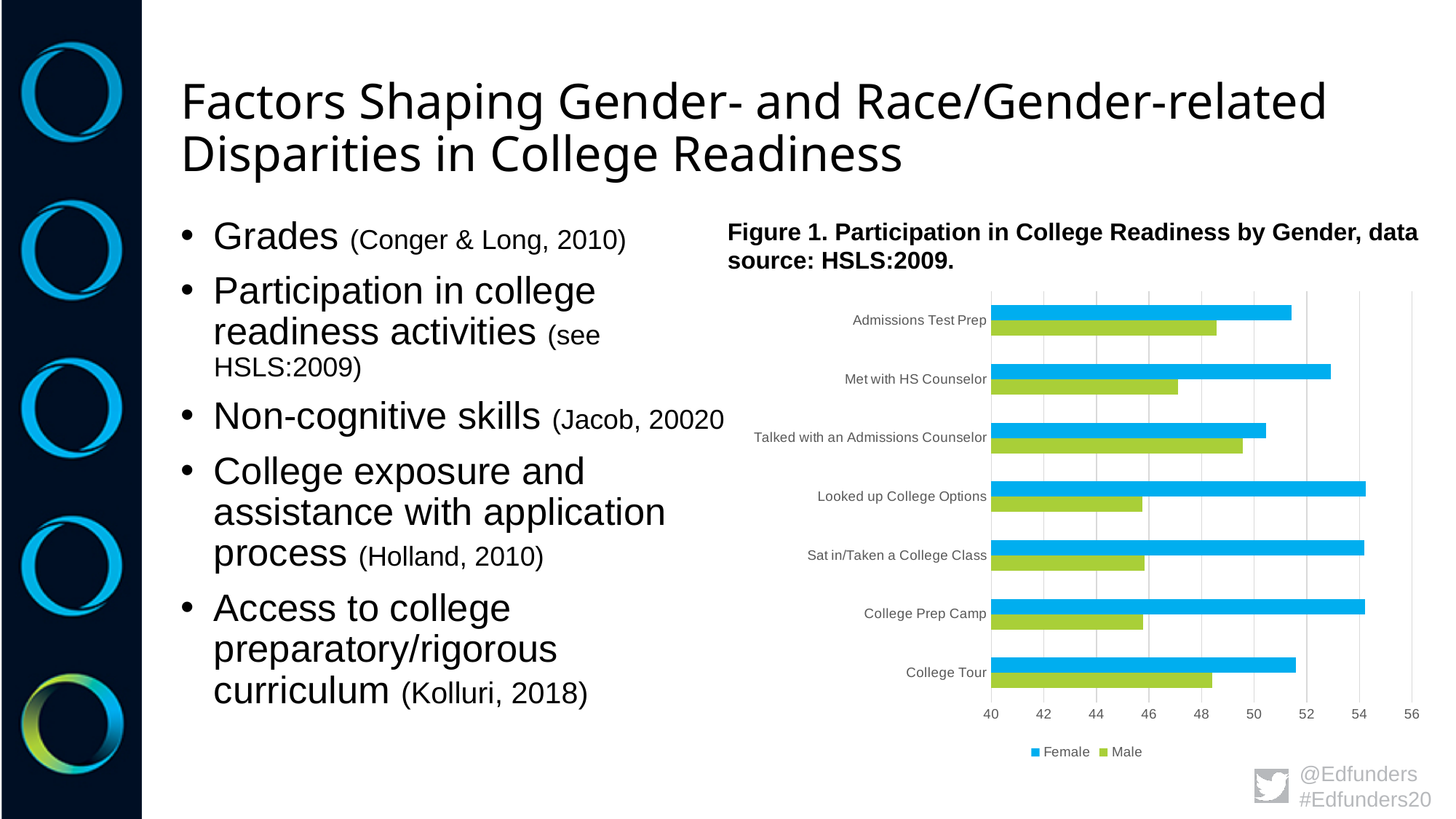
In Figure 1, which is larger for Met with HS Counselor, the Female value or the Male value? Female How many series does the legend of Figure 1 list? 2 In Figure 1, which colour represents the Male series? green In Figure 1, is the Female value for Met with HS Counselor greater or less than 52? greater How many activity categories are shown in Figure 1? 7 In Figure 1, which is larger for College Tour, the Female value or the Male value? Female In Figure 1, is the Female value for Looked up College Options greater or less than 52? greater In Figure 1, which category has the highest Male value? Talked with an Admissions Counselor In Figure 1, is the Male value for Met with HS Counselor greater or less than 48? less What is the title of the figure on the slide? Figure 1. Participation in College Readiness by Gender, data source: HSLS:2009. What kind of chart is shown in Figure 1? bar chart